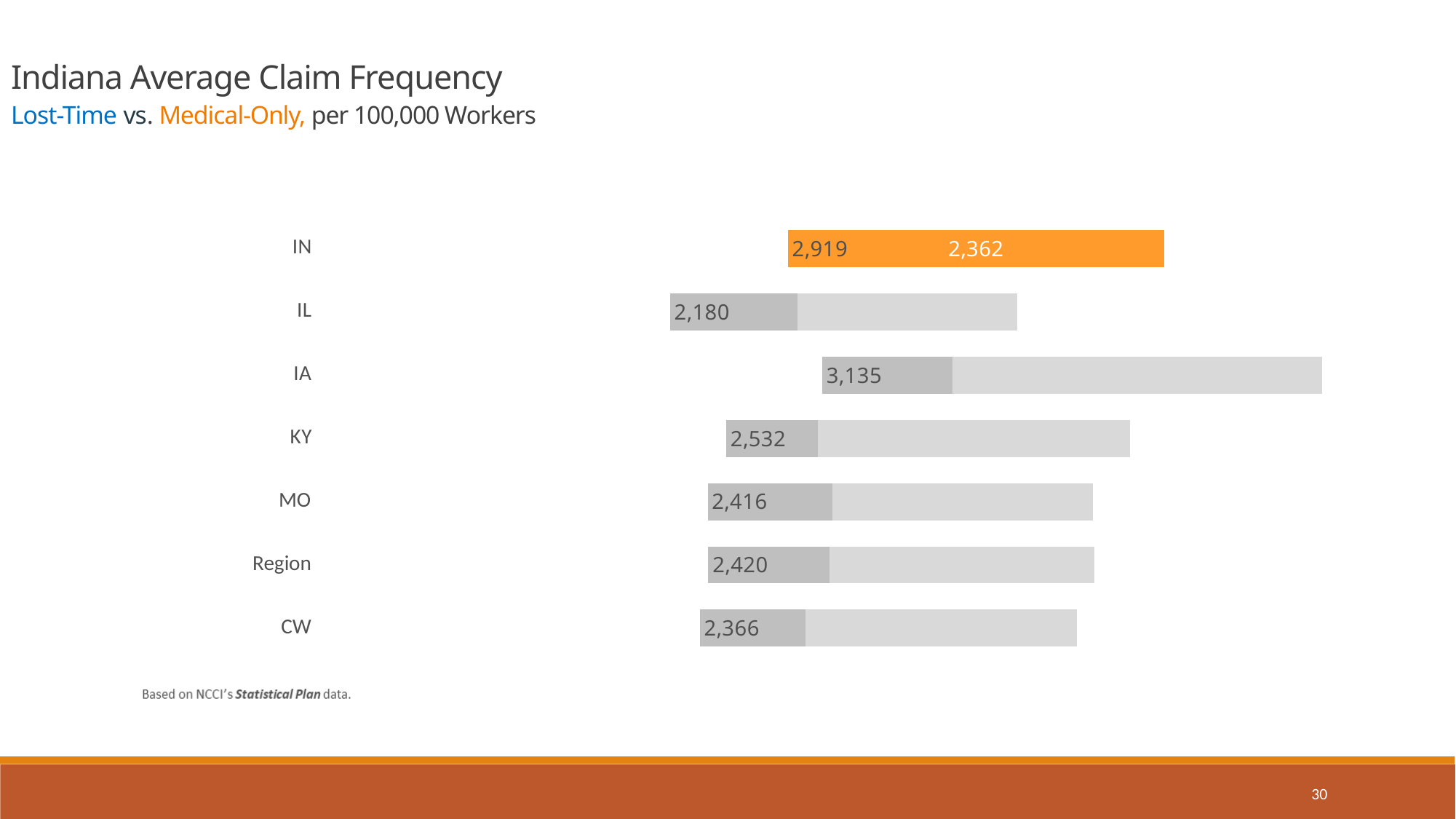
Which category has the highest printed value? IA What is the difference between the printed values for IA and IL? 955 What value is printed on the KY bar? 2,532 Which category has the lowest printed value? IL What value is printed on the CW bar? 2,366 Which category's bar is highlighted in orange? IN What kind of chart is shown on the slide? bar chart What two values are printed on the IN bar? 2,919 and 2,362 What value is printed on the IA bar? 3,135 What value is printed on the IL bar? 2,180 Which has the larger printed value, KY or MO? KY How many categories are listed on the chart? 7